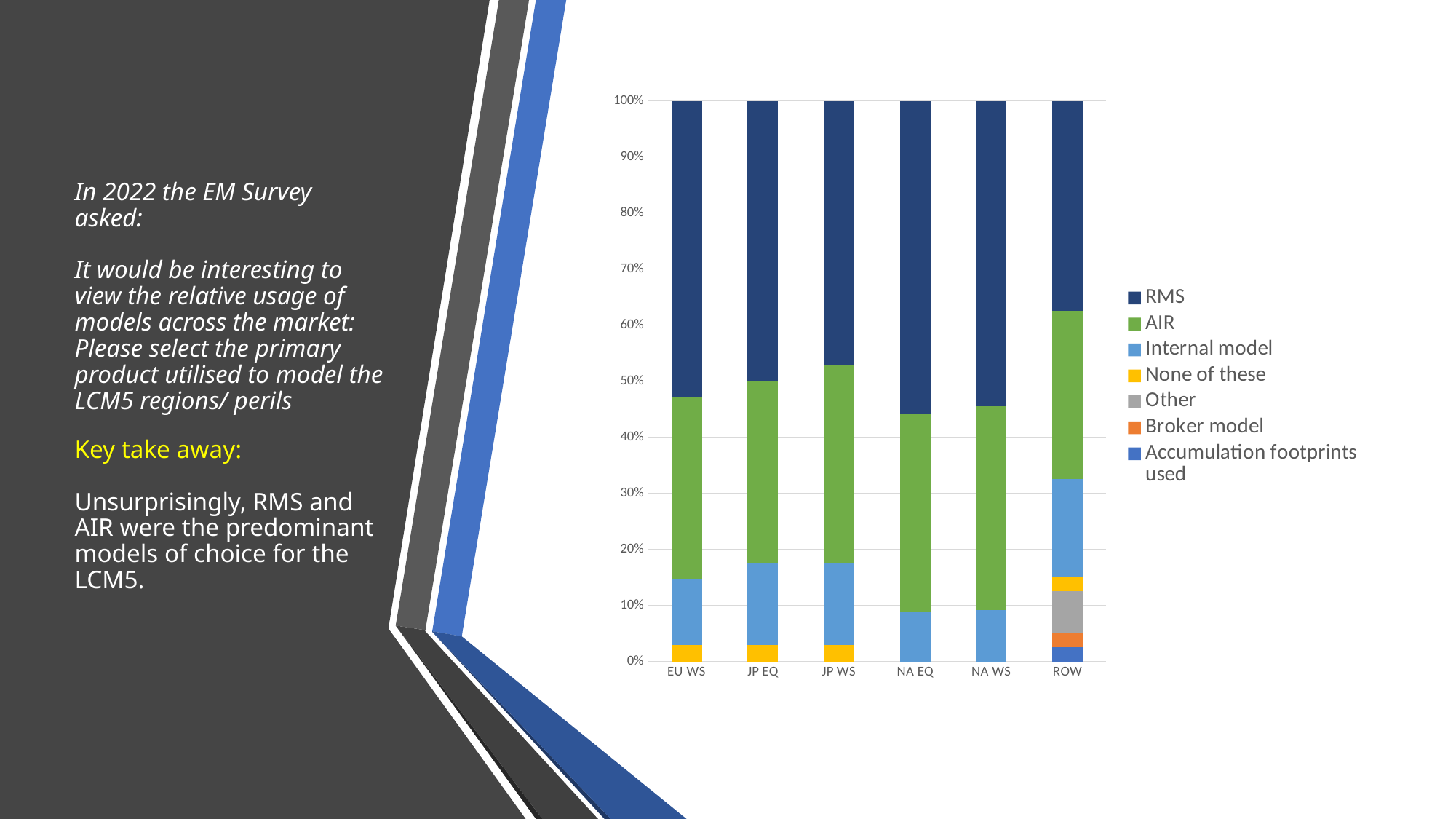
Is the Internal model share for ROW greater or less than 10%? greater Which is larger: the RMS share for EU WS or the RMS share for ROW? EU WS Which category has the smallest RMS share in the chart? ROW Is the RMS share for ROW greater or less than 50%? less How many categories are shown along the x axis of the chart? 6 How many series does the chart legend list? 7 Is the Internal model share for NA EQ greater or less than 10%? less Which series is shown in green in the chart? AIR Which is larger: the AIR share for ROW or the AIR share for NA EQ? NA EQ Which category's bar contains segments for all seven series in the legend? ROW What kind of chart is shown on the slide? Stacked bar chart